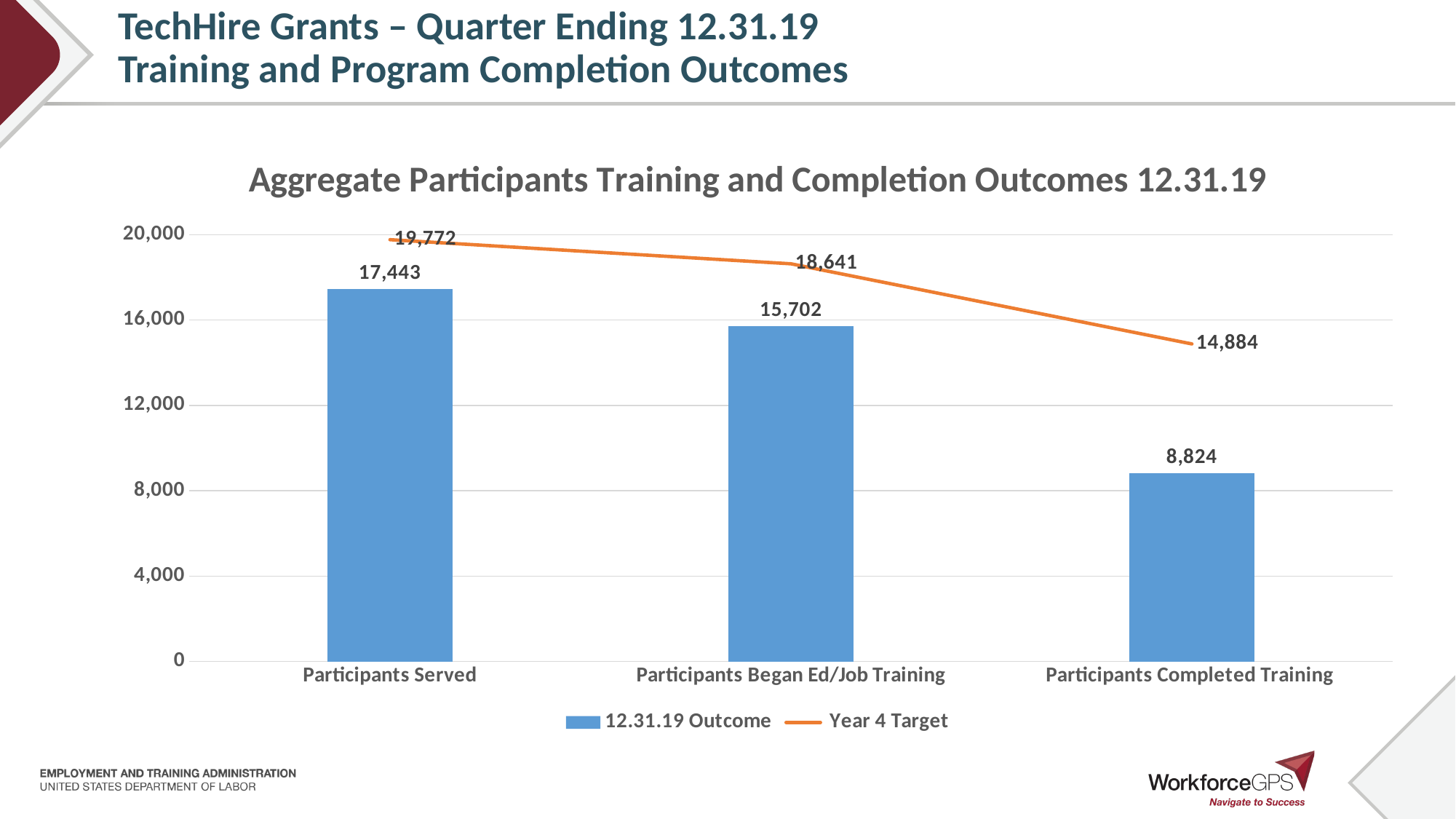
What is the 12.31.19 Outcome value for Participants Began Ed/Job Training? 15,702 What is the 12.31.19 Outcome value for Participants Served? 17,443 What is the Year 4 Target for Participants Served? 19,772 Which category has the highest Year 4 Target? Participants Served Which is larger for Participants Served: the 12.31.19 Outcome or the Year 4 Target? Year 4 Target How many series does the legend list? 2 What is the Year 4 Target for Participants Completed Training? 14,884 How many categories are shown on the x axis? 3 Which category has the lowest 12.31.19 Outcome value? Participants Completed Training Do the Year 4 Target values rise or fall from left to right across the categories? fall What is the difference between the Year 4 Target and the 12.31.19 Outcome for Participants Completed Training? 6,060 What is the difference between the Year 4 Target and the 12.31.19 Outcome for Participants Began Ed/Job Training? 2,939